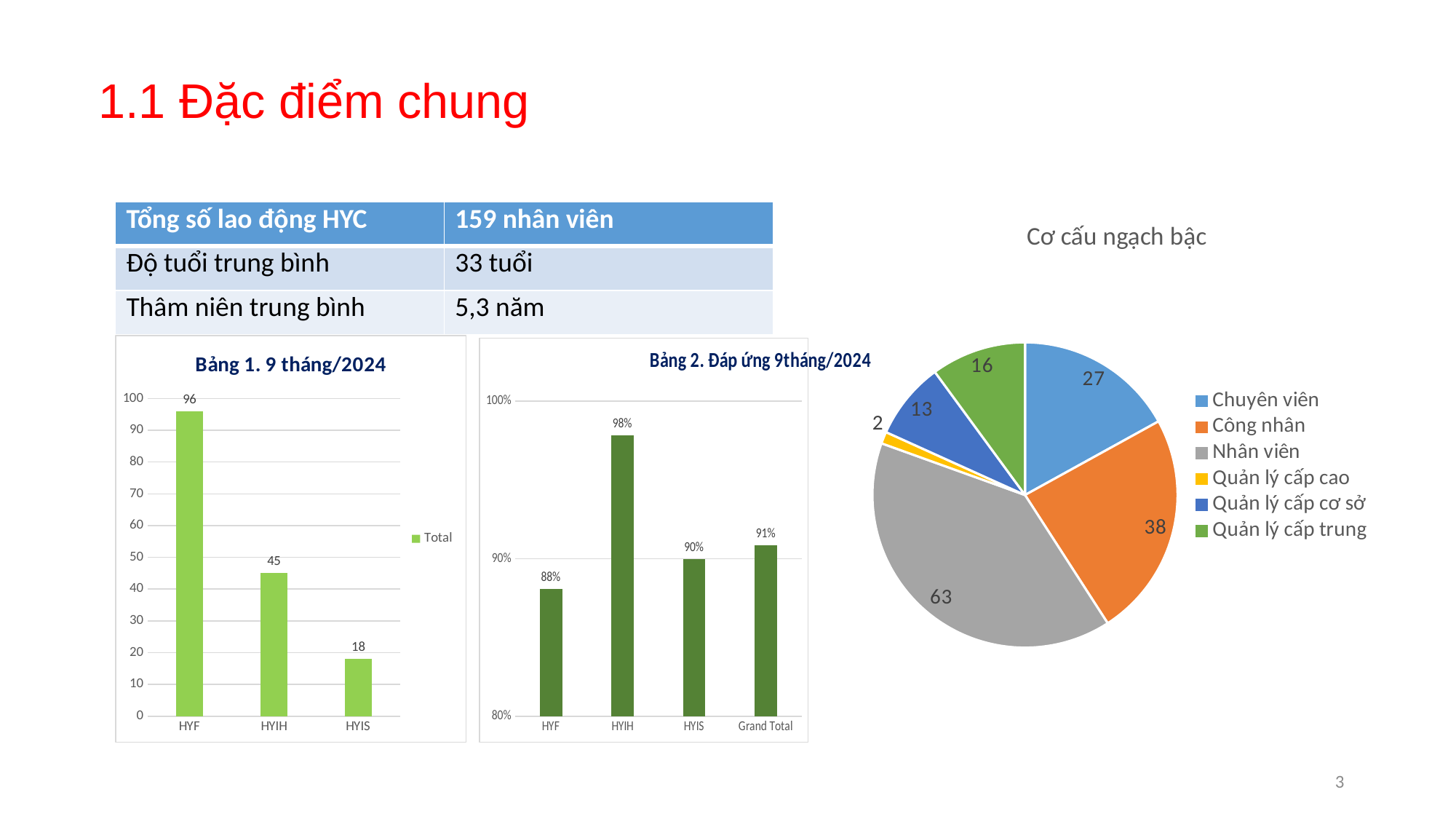
In the chart titled 'Bảng 1. 9 tháng/2024', what is the difference between the values for HYF and HYIH? 51 In the chart titled 'Bảng 2. Đáp ứng 9tháng/2024', what is the value for Grand Total? 91% In the pie chart titled 'Cơ cấu ngạch bậc', what is the value for Nhân viên? 63 In the chart titled 'Bảng 1. 9 tháng/2024', which category has the lowest value? HYIS In the chart titled 'Bảng 2. Đáp ứng 9tháng/2024', which is larger, the value for HYF or the value for HYIS? HYIS In the pie chart titled 'Cơ cấu ngạch bậc', how many categories does the legend list? 6 In the chart titled 'Bảng 2. Đáp ứng 9tháng/2024', what is the value for HYIH? 98% In the chart titled 'Bảng 1. 9 tháng/2024', how many categories are shown on the x axis? 3 In the pie chart titled 'Cơ cấu ngạch bậc', which category has the smallest slice? Quản lý cấp cao In the chart titled 'Bảng 2. Đáp ứng 9tháng/2024', which category has the highest value? HYIH What kind of chart is the chart titled 'Bảng 1. 9 tháng/2024'? Bar chart In the chart titled 'Bảng 1. 9 tháng/2024', what is the value for HYF? 96